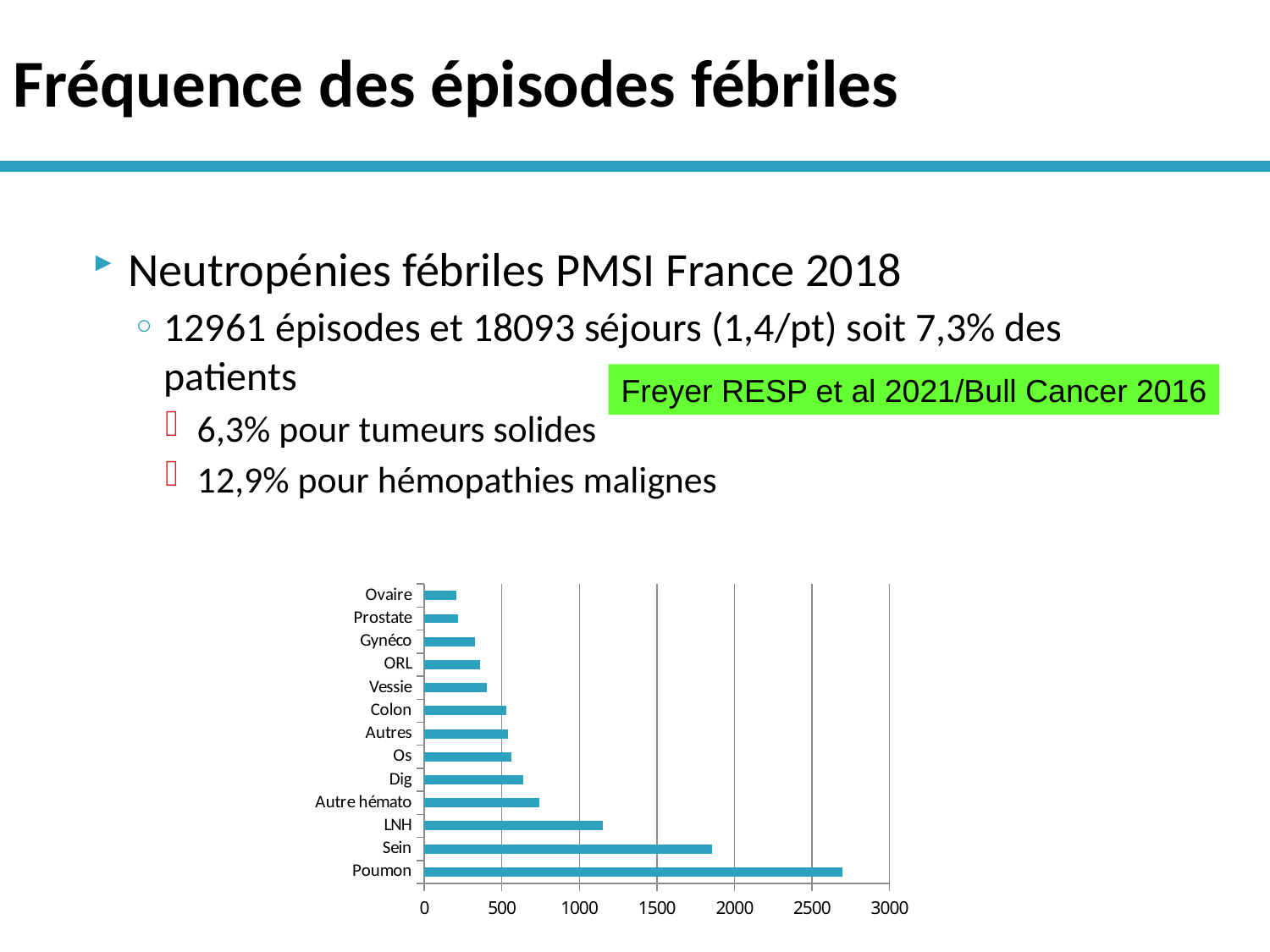
What kind of chart is shown on the slide? bar chart Is the value for Vessie greater or less than 500? less How many categories are plotted in the bar chart? 13 Which category has the highest value in the bar chart? Poumon Is the value for Poumon greater or less than 2500? greater What is the maximum value shown on the horizontal axis of the bar chart? 3000 Which has a larger value, Sein or LNH? Sein Which has a larger value, Autre hémato or Dig? Autre hémato Is the value for Sein greater or less than 2000? less Which category is listed at the top of the bar chart? Ovaire